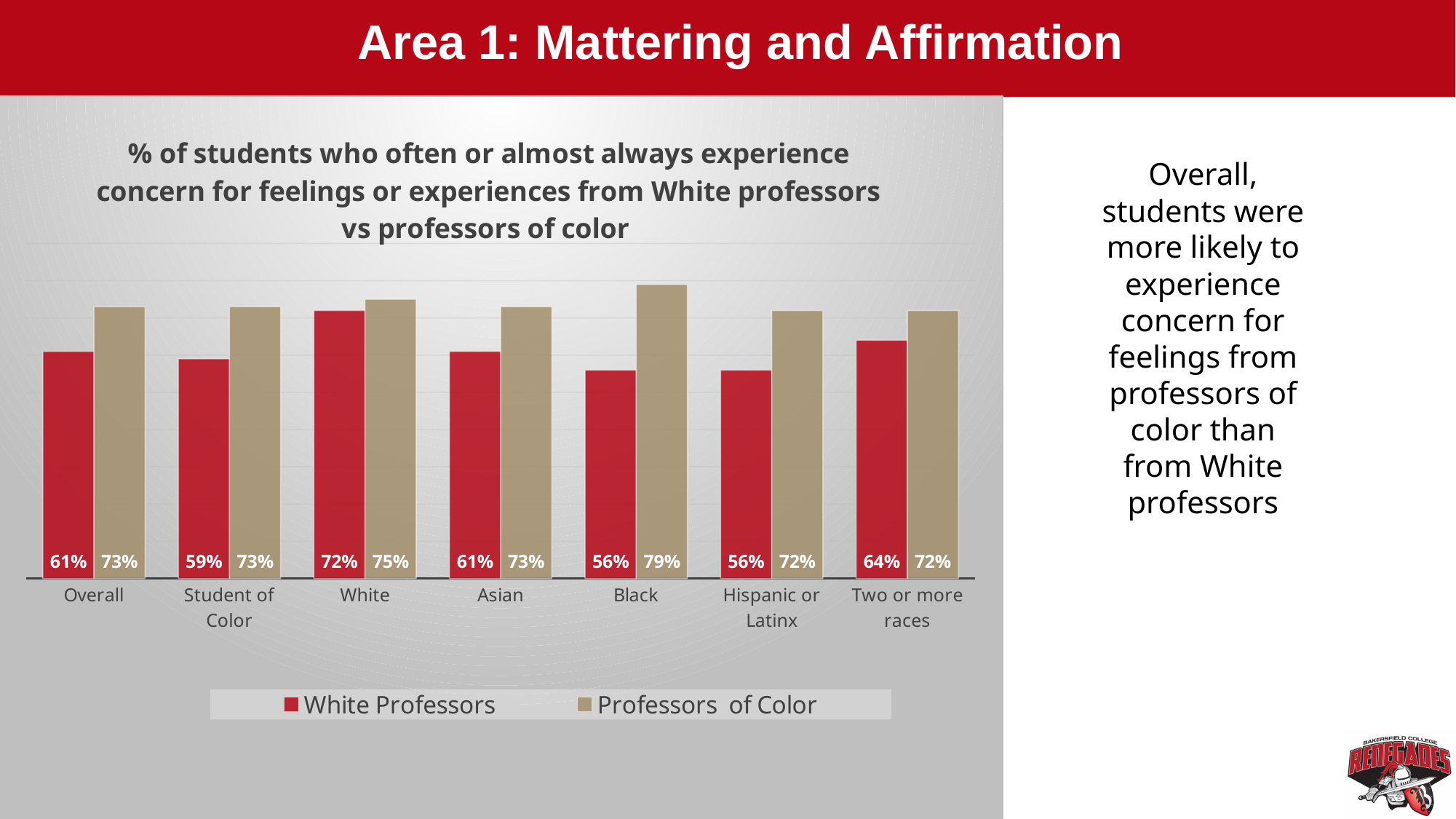
Which category has the highest value for White Professors? White What is the value for White Professors in the Two or more races category? 64% What is the difference between Professors of Color and White Professors in the White category? 3% How many categories are shown on the x axis? 7 What is the value for Professors of Color in the Black category? 79% Which category has the highest value for Professors of Color? Black Which is larger in the Asian category: White Professors or Professors of Color? Professors of Color What is the value for White Professors in the Overall category? 61% What is the difference between Professors of Color and White Professors in the Black category? 23% What kind of chart is shown on the slide? Bar chart Which colour represents the White Professors series? Red How many series does the legend list? 2